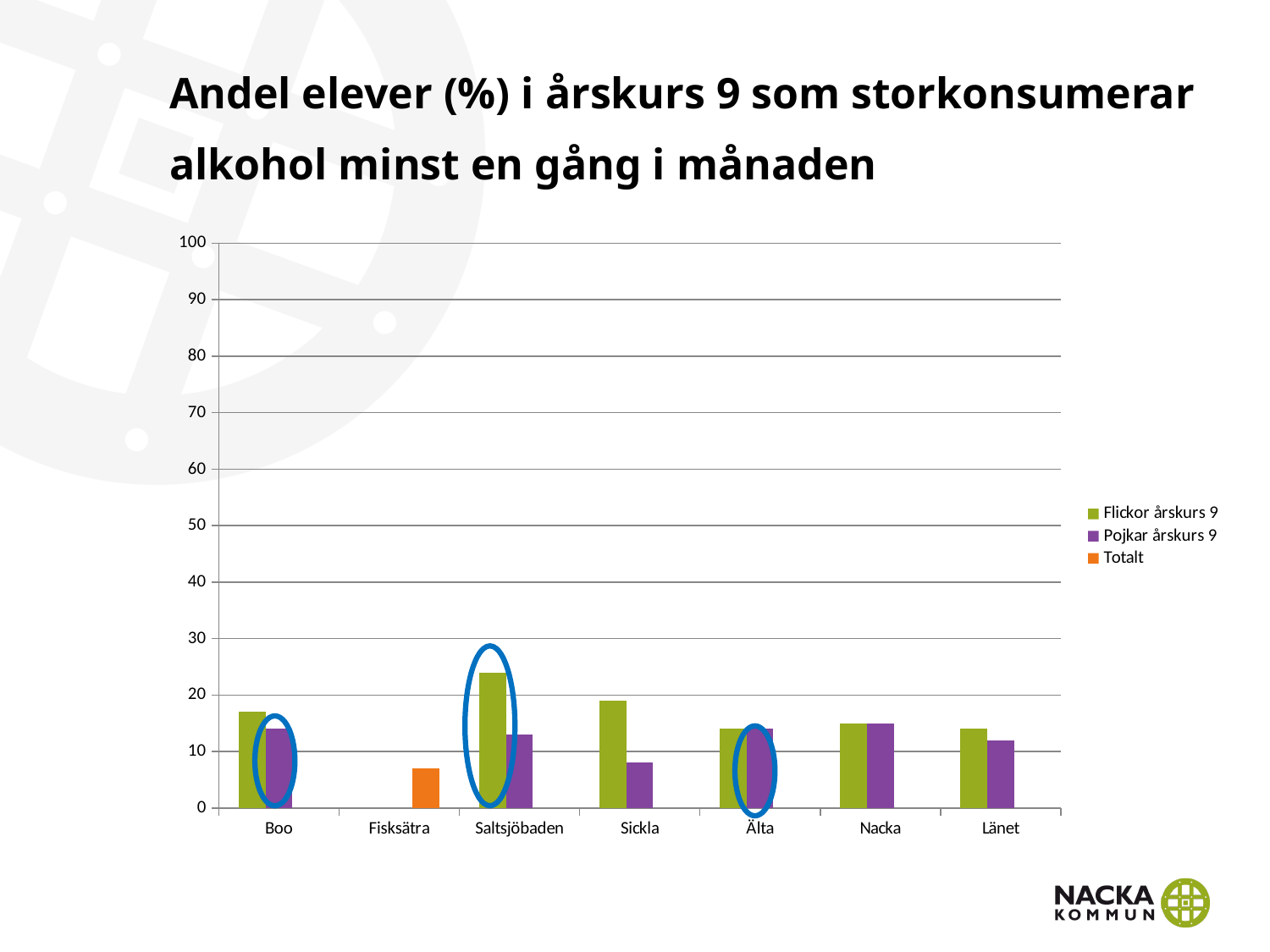
How many categories are shown on the x axis? 7 What colour represents Pojkar årskurs 9 in the legend? purple Is the value for Flickor årskurs 9 in Saltsjöbaden greater or less than 20? greater Is the value for Flickor årskurs 9 in Boo greater or less than 20? less Is the value for Pojkar årskurs 9 in Sickla greater or less than 10? less Which category has the lowest value for Pojkar årskurs 9? Sickla Which category shows only a Totalt bar and no Flickor or Pojkar bars? Fisksätra Which category has the highest value for Flickor årskurs 9? Saltsjöbaden What kind of chart is shown on the slide? bar chart In Sickla, which is larger: Flickor årskurs 9 or Pojkar årskurs 9? Flickor årskurs 9 How many series does the legend list? 3